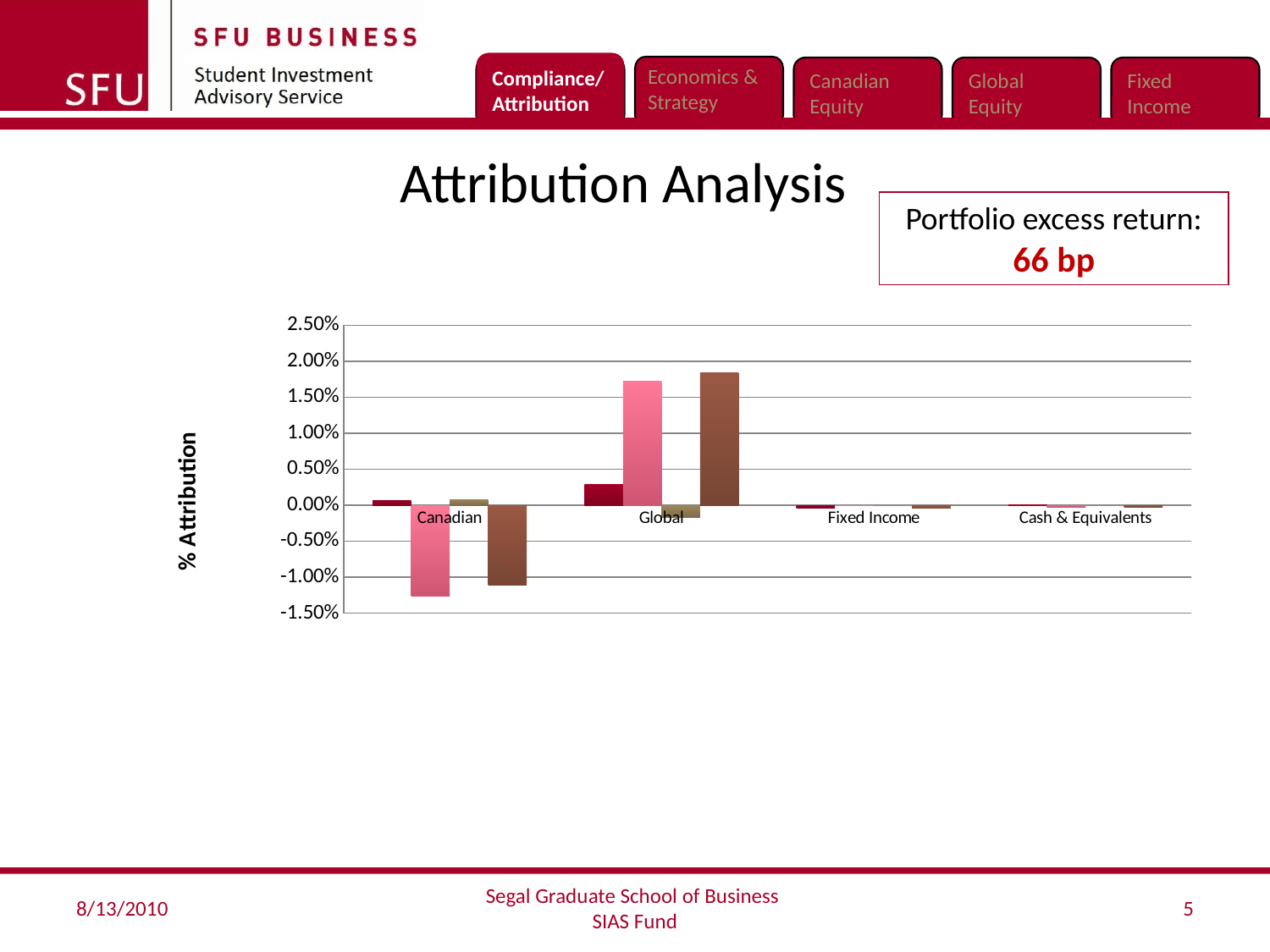
For the Global category, which is larger: the brown bar or the pink bar? the brown bar Which category contains the tallest positive bar in the chart? Global Is the value of the pink bar for Canadian greater or less than -1.00%? less Which category contains the lowest (most negative) bar in the chart? Canadian How many categories are shown on the x axis of the chart? 4 What kind of chart is shown on the slide? bar chart What is the label on the vertical axis of the chart? % Attribution Is the value of the brown bar for Global greater or less than 2.00%? less How many bars are plotted for each category in the chart? 4 Is the value of the dark red bar for Global greater or less than 0.50%? less What is the highest value shown on the vertical axis of the chart? 2.50%